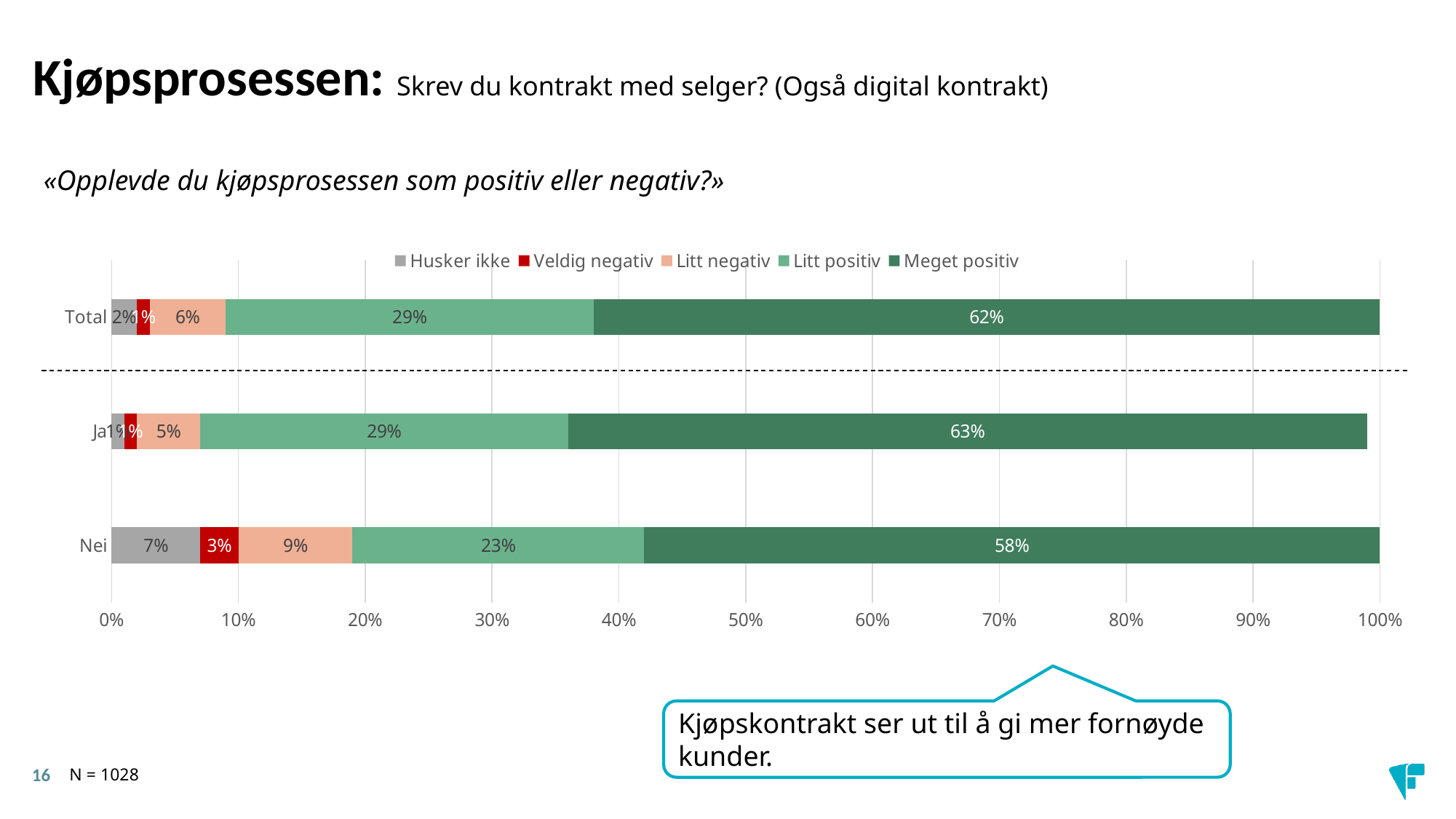
Which has a larger Husker ikke value, Total or Nei? Nei What is the value for Veldig negativ in the Nei bar? 3% Which category has the lowest value for Meget positiv? Nei What is the value for Meget positiv in the Ja bar? 63% How many series does the legend list? 5 What kind of chart is shown on the slide? Stacked bar chart What is the value for Litt negativ in the Nei bar? 9% How many categories (bars) are shown in the chart? 3 What is the total of the Nei stacked bar? 100% What is the value for Meget positiv in the Nei bar? 58% What is the value for Litt positiv in the Total bar? 29% What is the difference between the Meget positiv values for Ja and Nei? 5 percentage points